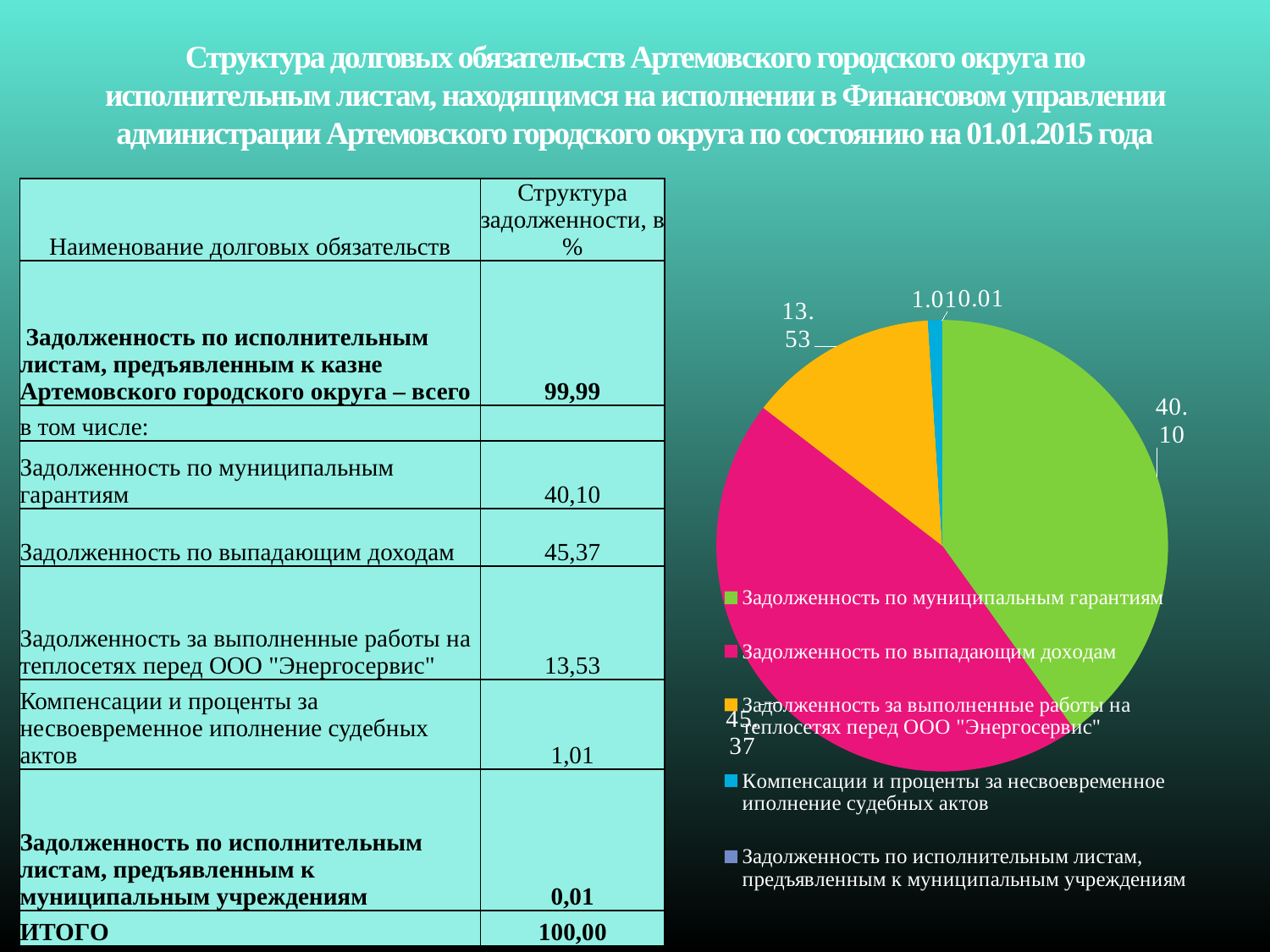
Which slice of the pie chart is the largest? Задолженность по выпадающим доходам How many slices does the pie chart have? 5 Which slice of the pie chart is the smallest? Задолженность по исполнительным листам, предъявленным к муниципальным учреждениям In the pie chart, which is larger: 'Задолженность по муниципальным гарантиям' or 'Задолженность за выполненные работы на теплосетях перед ООО "Энергосервис"'? Задолженность по муниципальным гарантиям What value is shown for the slice 'Задолженность по муниципальным гарантиям' in the pie chart? 40.10 What is the difference between the values for 'Задолженность по выпадающим доходам' and 'Задолженность по муниципальным гарантиям' in the pie chart? 5.27 What kind of chart is shown on the slide? pie chart How many entries does the legend of the pie chart list? 5 What colour is the slice for 'Задолженность по выпадающим доходам' in the pie chart? pink (magenta) What value is shown for the slice 'Компенсации и проценты за несвоевременное иполнение судебных актов' in the pie chart? 1.01 What value is shown for the slice 'Задолженность по выпадающим доходам' in the pie chart? 45.37 What value is shown for the slice 'Задолженность за выполненные работы на теплосетях перед ООО "Энергосервис"' in the pie chart? 13.53